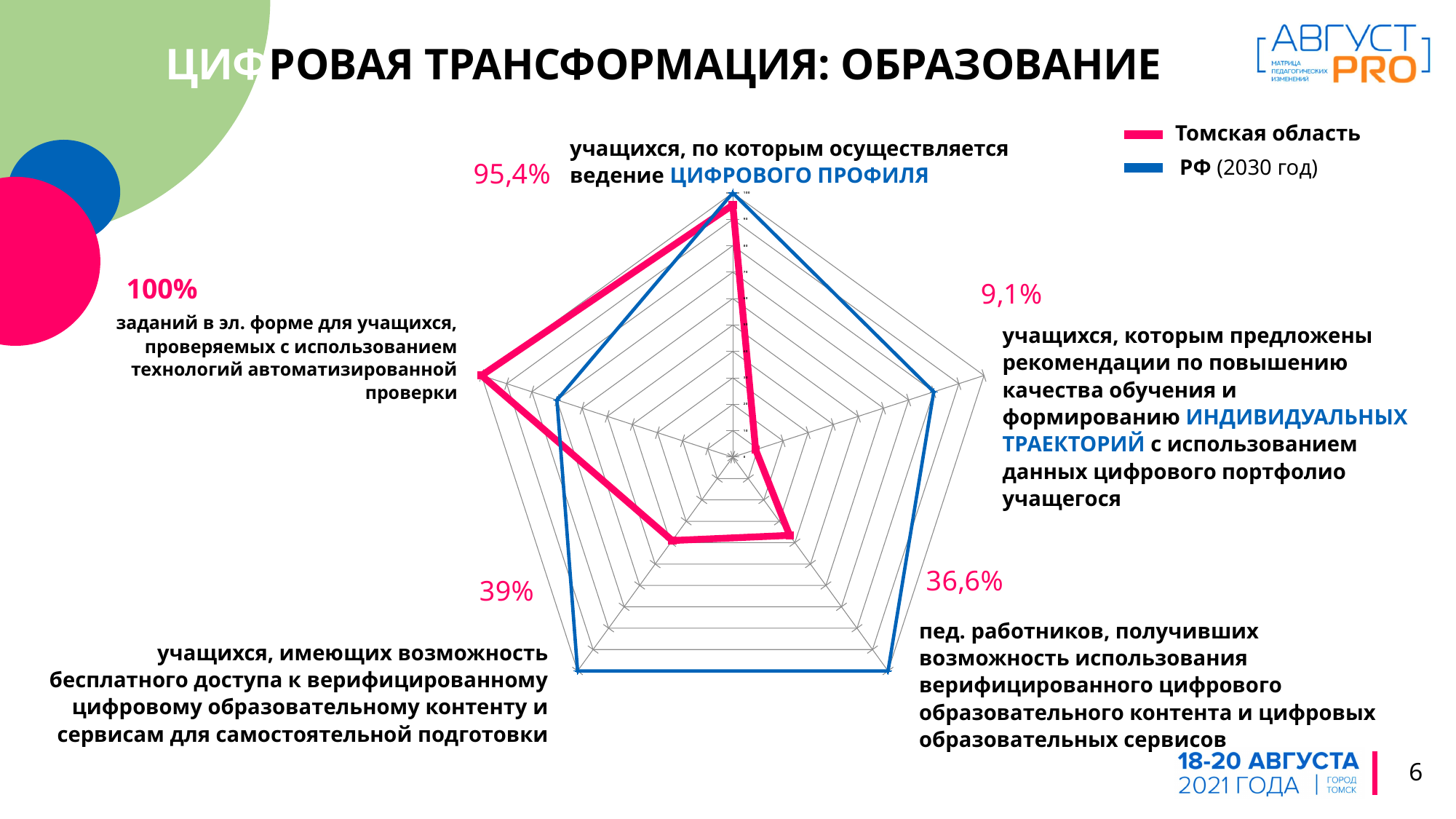
What is the Томская область value for учащихся, которым предложены рекомендации по формированию индивидуальных траекторий? 9,1% Which colour represents Томская область in the legend? Pink How many categories (axes) does the radar chart have? 5 What is the Томская область value for заданий в эл. форме, проверяемых с использованием технологий автоматизированной проверки? 100% Which category has the lowest Томская область value? Учащихся, которым предложены рекомендации по формированию индивидуальных траекторий (9,1%) What is the Томская область value for пед. работников, получивших возможность использования верифицированного цифрового образовательного контента? 36,6% What is the Томская область value for учащихся, имеющих возможность бесплатного доступа к верифицированному цифровому образовательному контенту? 39% What is the Томская область value for учащихся, по которым осуществляется ведение цифрового профиля? 95,4% What kind of chart is shown on the slide? Radar chart Which category has the highest Томская область value? Заданий в эл. форме, проверяемых с использованием технологий автоматизированной проверки (100%) What is the difference between the Томская область values for бесплатного доступа к контенту (39%) and пед. работников (36,6%)? 2,4% How many series does the legend list? 2